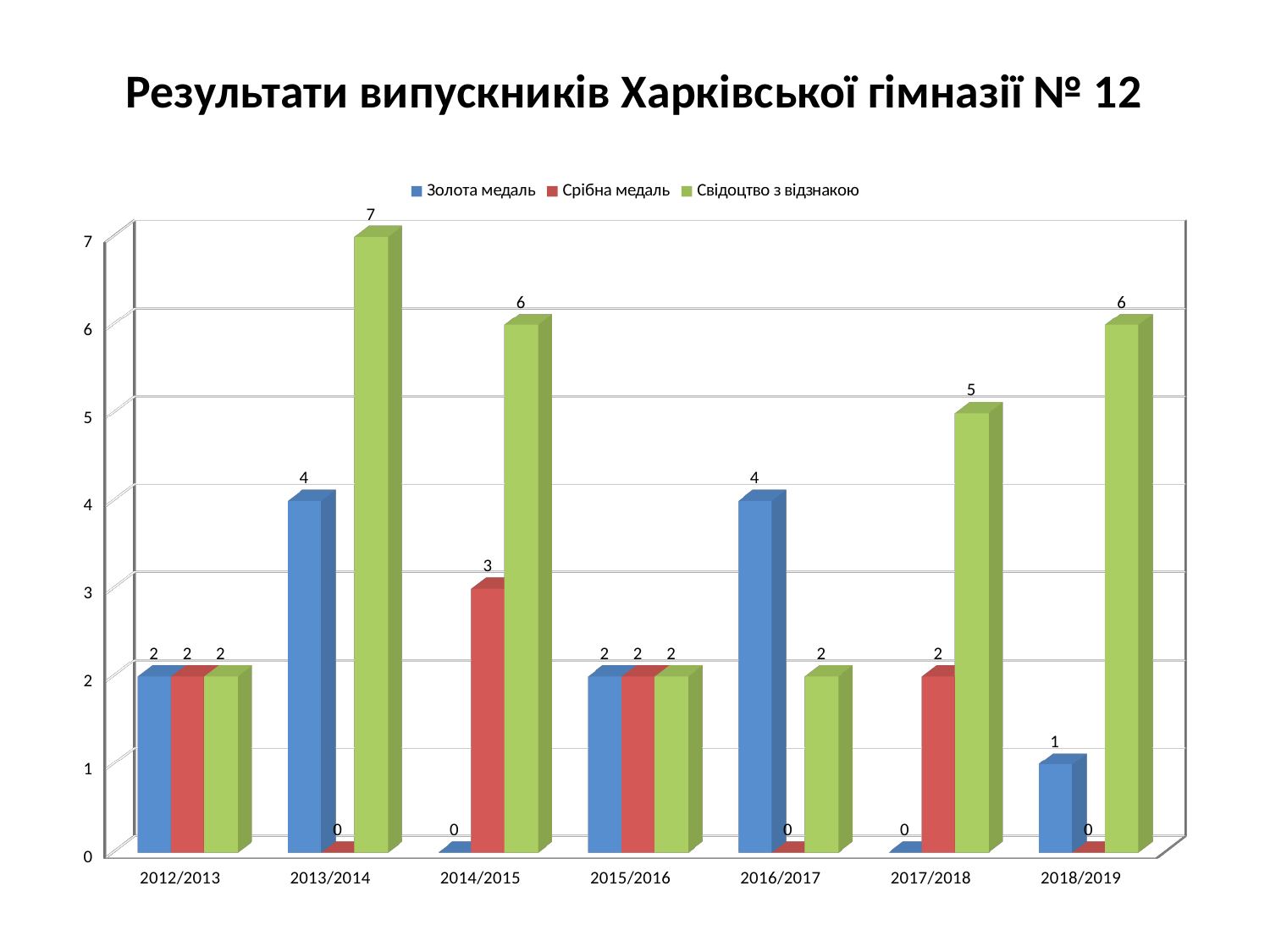
What is the value for Золота медаль in 2018/2019? 1 What is the title of the chart on the slide? Результати випускників Харківської гімназії № 12 In which school year is the value for Срібна медаль the highest? 2014/2015 How many school years (categories) are shown on the x axis? 7 Which colour represents Срібна медаль in the chart? red Which is larger in 2016/2017: Золота медаль or Свідоцтво з відзнакою? Золота медаль What is the value for Срібна медаль in 2014/2015? 3 What is the value for Свідоцтво з відзнакою in 2013/2014? 7 How many series does the legend list? 3 What is the difference between Свідоцтво з відзнакою and Золота медаль in 2017/2018? 5 In which school year is the value for Свідоцтво з відзнакою the highest? 2013/2014 What type of chart is shown on the slide? bar chart